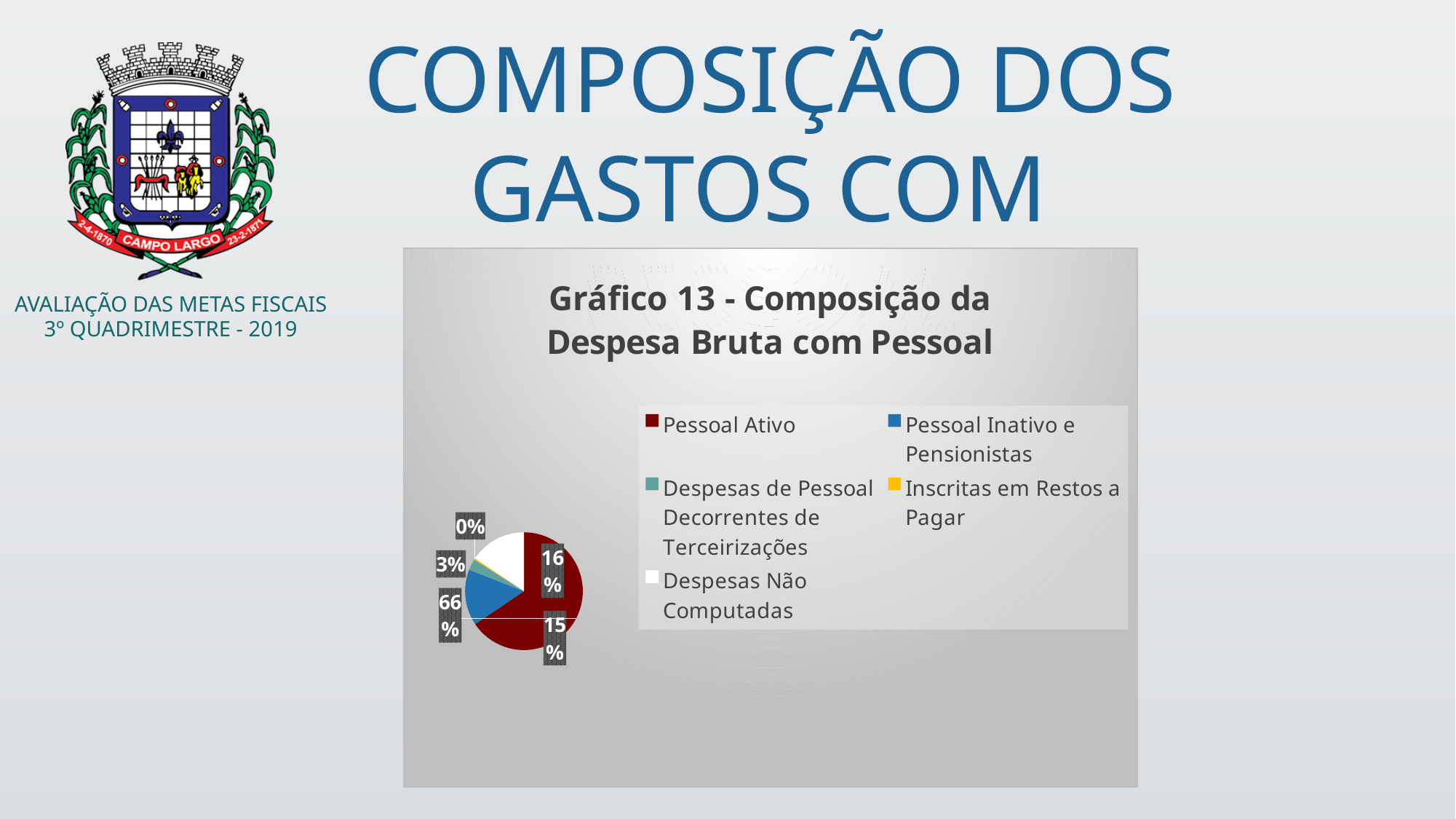
Which slice is larger in the pie chart, Pessoal Ativo or Pessoal Inativo e Pensionistas? Pessoal Ativo Which slice is larger in the pie chart, Pessoal Ativo or Despesas Não Computadas? Pessoal Ativo What colour represents Pessoal Ativo in the pie chart legend? dark red How many categories does the legend of the pie chart list? 5 What is the title of the chart on the slide? Gráfico 13 - Composição da Despesa Bruta com Pessoal What is the smallest percentage label shown on the pie chart? 0% Is the Pessoal Ativo slice of the pie chart greater or less than 50%? greater What kind of chart is Gráfico 13 on the slide? pie chart Which category has the largest slice of the pie chart? Pessoal Ativo What is the largest percentage label shown on the pie chart? 66% How many percentage data labels are shown on the pie chart? 5